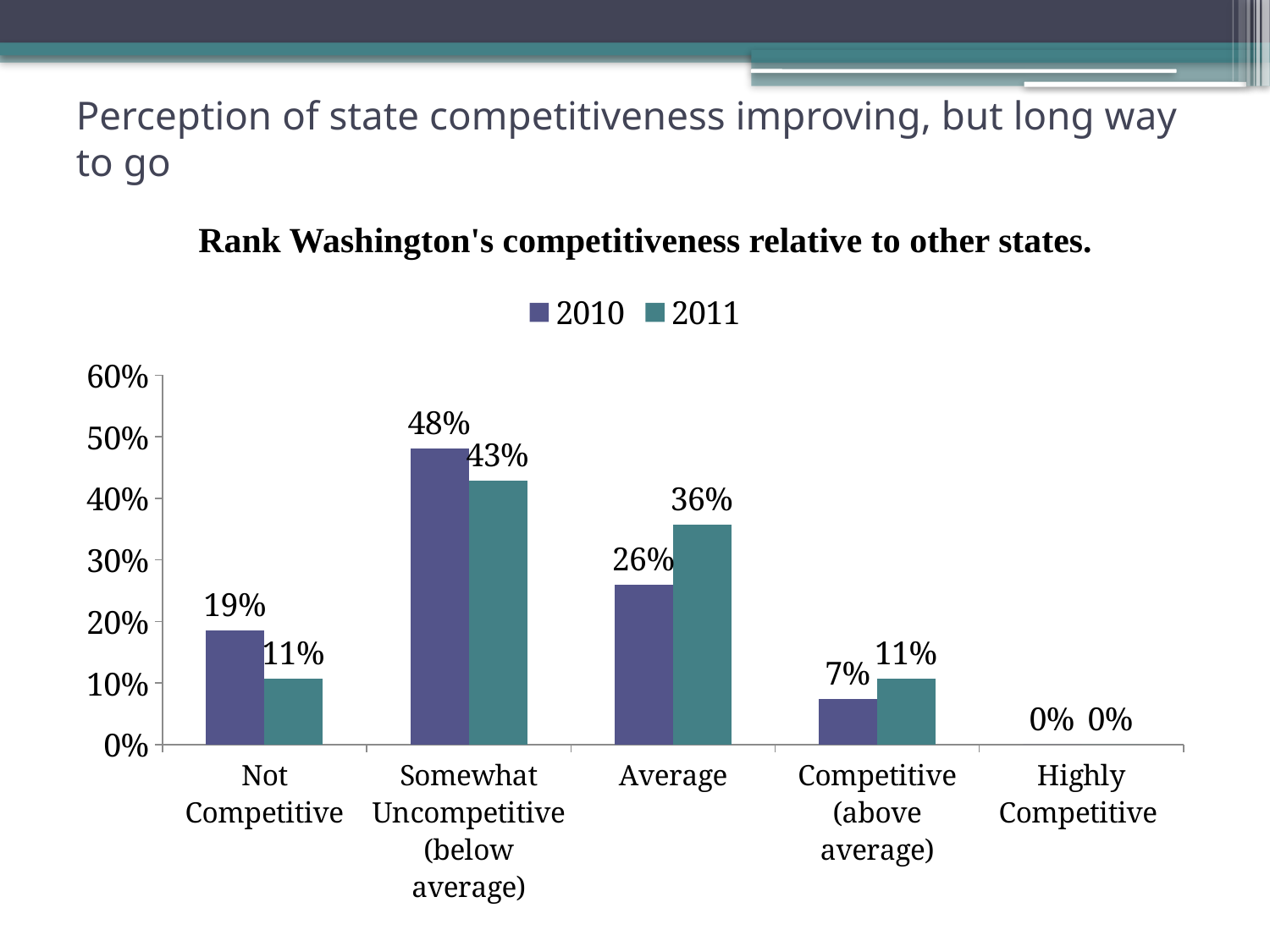
How many categories are shown on the x axis? 5 What is the 2011 value for Average? 36% Which is larger for Average: the 2010 value or the 2011 value? 2011 Which category has the highest 2011 value? Somewhat Uncompetitive (below average) What is the difference between the 2011 values for Somewhat Uncompetitive (below average) and Average? 7% How many series does the legend list? 2 Which category has the lowest 2010 value? Highly Competitive What is the title of the chart? Rank Washington's competitiveness relative to other states. What is the 2010 value for Competitive (above average)? 7% What is the 2010 value for Somewhat Uncompetitive (below average)? 48% What kind of chart is shown? bar chart What is the difference between the 2010 and 2011 values for Not Competitive? 8%